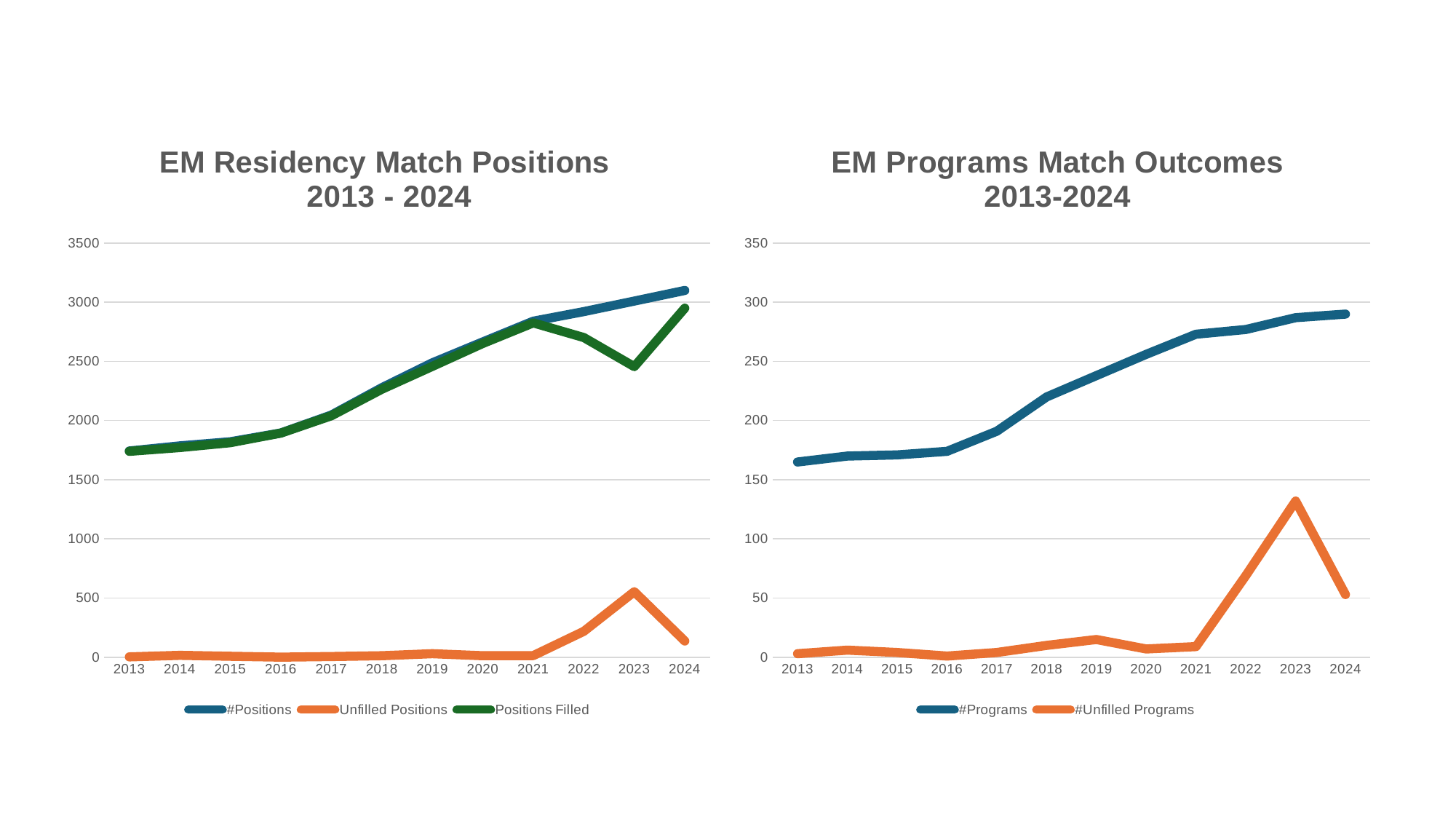
How many series does the legend of the 'EM Programs Match Outcomes 2013-2024' chart list? 2 In the 'EM Programs Match Outcomes 2013-2024' chart, does #Programs generally rise or fall from 2013 to 2024? rise In the 'EM Programs Match Outcomes 2013-2024' chart, is the value of #Programs in 2024 greater or less than 300? less How many years are plotted along the x axis of the 'EM Programs Match Outcomes 2013-2024' chart? 12 In the 'EM Residency Match Positions 2013 - 2024' chart, which is larger in 2024: #Positions or Positions Filled? #Positions In the 'EM Residency Match Positions 2013 - 2024' chart, is the value of #Positions in 2024 greater or less than 3000? greater In the 'EM Residency Match Positions 2013 - 2024' chart, is the value of Positions Filled in 2023 greater or less than 2500? less What type of chart is the 'EM Residency Match Positions 2013 - 2024' chart? line chart In the 'EM Residency Match Positions 2013 - 2024' chart, in which year is Unfilled Positions highest? 2023 In the 'EM Programs Match Outcomes 2013-2024' chart, in which year is #Unfilled Programs highest? 2023 How many series does the legend of the 'EM Residency Match Positions 2013 - 2024' chart list? 3